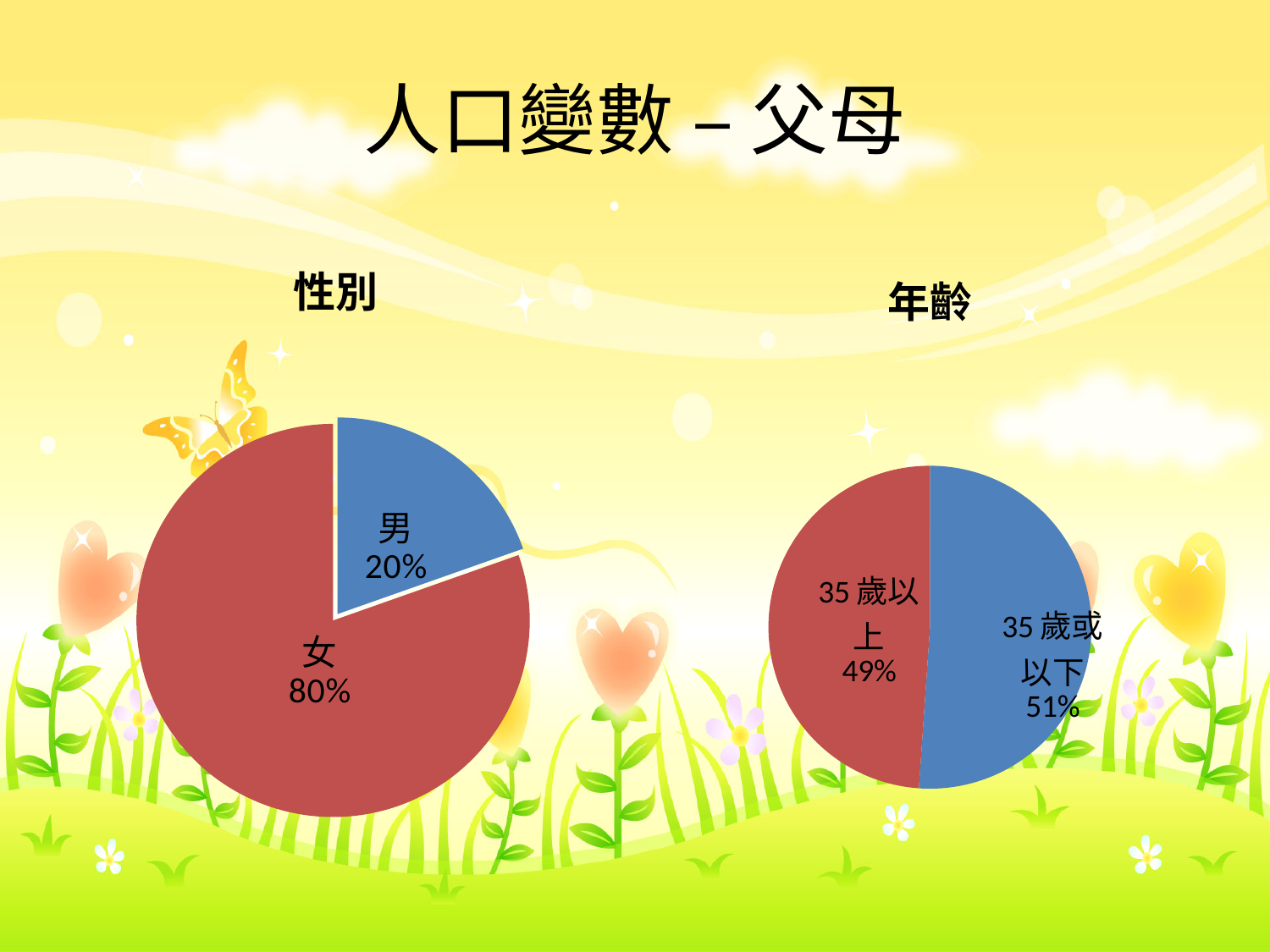
In the 年齡 pie chart, what percentage is 35 歲或以下? 51% What is the title of the slide? 人口變數 – 父母 In the 性別 pie chart, what percentage is 男? 20% In the 性別 pie chart, which slice is the largest? 女 In the 性別 pie chart, which slice is the smallest? 男 In the 性別 pie chart, what is the difference in percentage points between 女 and 男? 60 How many slices does the 性別 pie chart have? 2 In the 年齡 pie chart, what percentage is 35 歲以上? 49% In the 年齡 pie chart, what is the difference in percentage points between 35 歲或以下 and 35 歲以上? 2 In the 年齡 pie chart, which is larger according to the printed labels, 35 歲或以下 or 35 歲以上? 35 歲或以下 What type of chart is the 年齡 chart? Pie chart In the 性別 pie chart, what percentage is 女? 80%